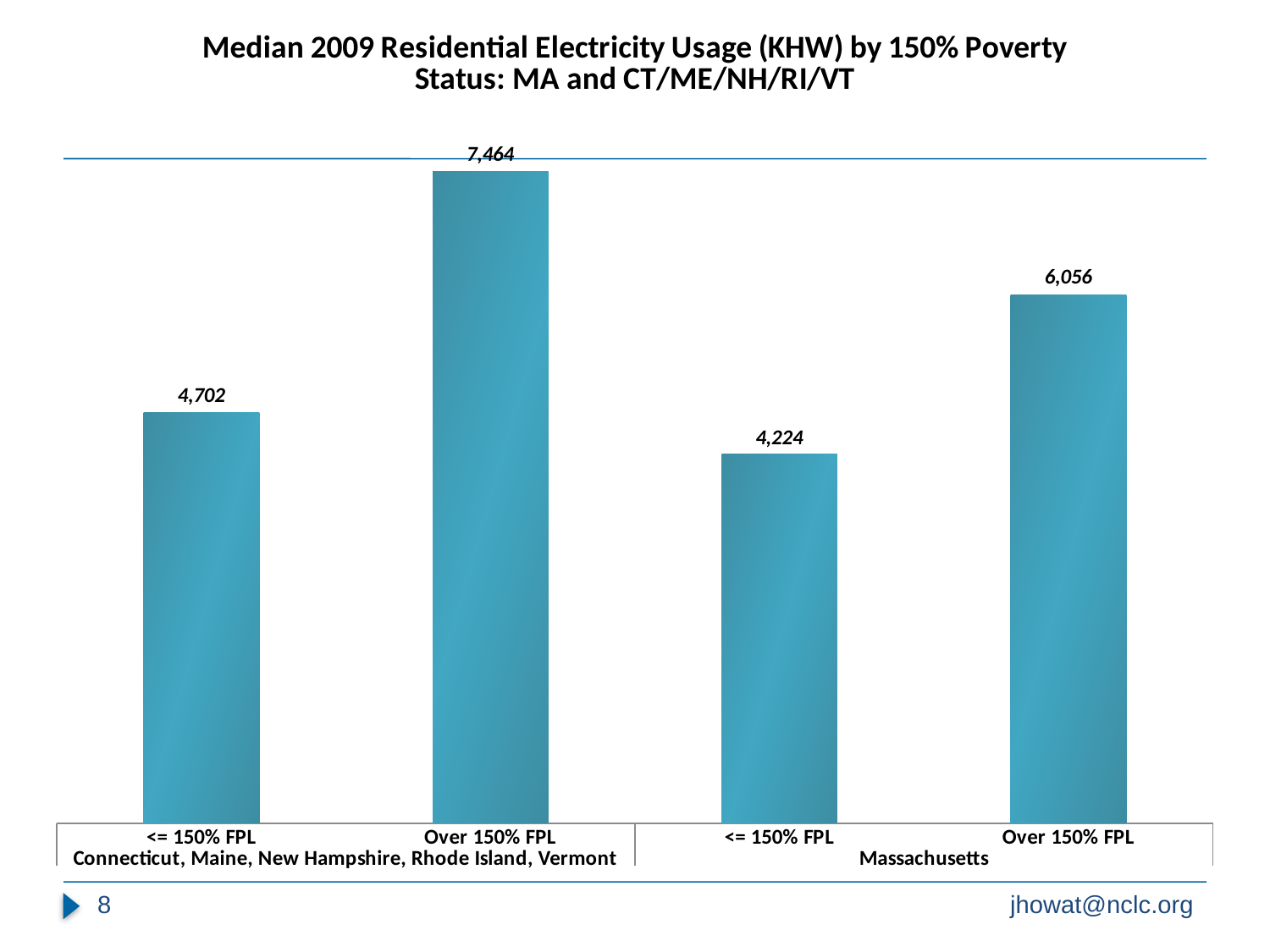
What is the median 2009 residential electricity usage for households at or below 150% FPL in Connecticut, Maine, New Hampshire, Rhode Island, Vermont? 4,702 What is the median 2009 residential electricity usage for households over 150% FPL in Connecticut, Maine, New Hampshire, Rhode Island, Vermont? 7,464 What is the median 2009 residential electricity usage for households at or below 150% FPL in Massachusetts? 4,224 What is the difference between the Over 150% FPL and <= 150% FPL values for Massachusetts? 1,832 Which bar has the highest value on the chart? Over 150% FPL, Connecticut, Maine, New Hampshire, Rhode Island, Vermont What is the difference between the Over 150% FPL values for Connecticut, Maine, New Hampshire, Rhode Island, Vermont and for Massachusetts? 1,408 Which bar has the lowest value on the chart? <= 150% FPL, Massachusetts What is the title of the chart? Median 2009 Residential Electricity Usage (KHW) by 150% Poverty Status: MA and CT/ME/NH/RI/VT What kind of chart is shown on the slide? Bar chart What is the median 2009 residential electricity usage for households over 150% FPL in Massachusetts? 6,056 Which is larger: the <= 150% FPL value for Connecticut, Maine, New Hampshire, Rhode Island, Vermont or the <= 150% FPL value for Massachusetts? Connecticut, Maine, New Hampshire, Rhode Island, Vermont How many bars are plotted on the chart? 4